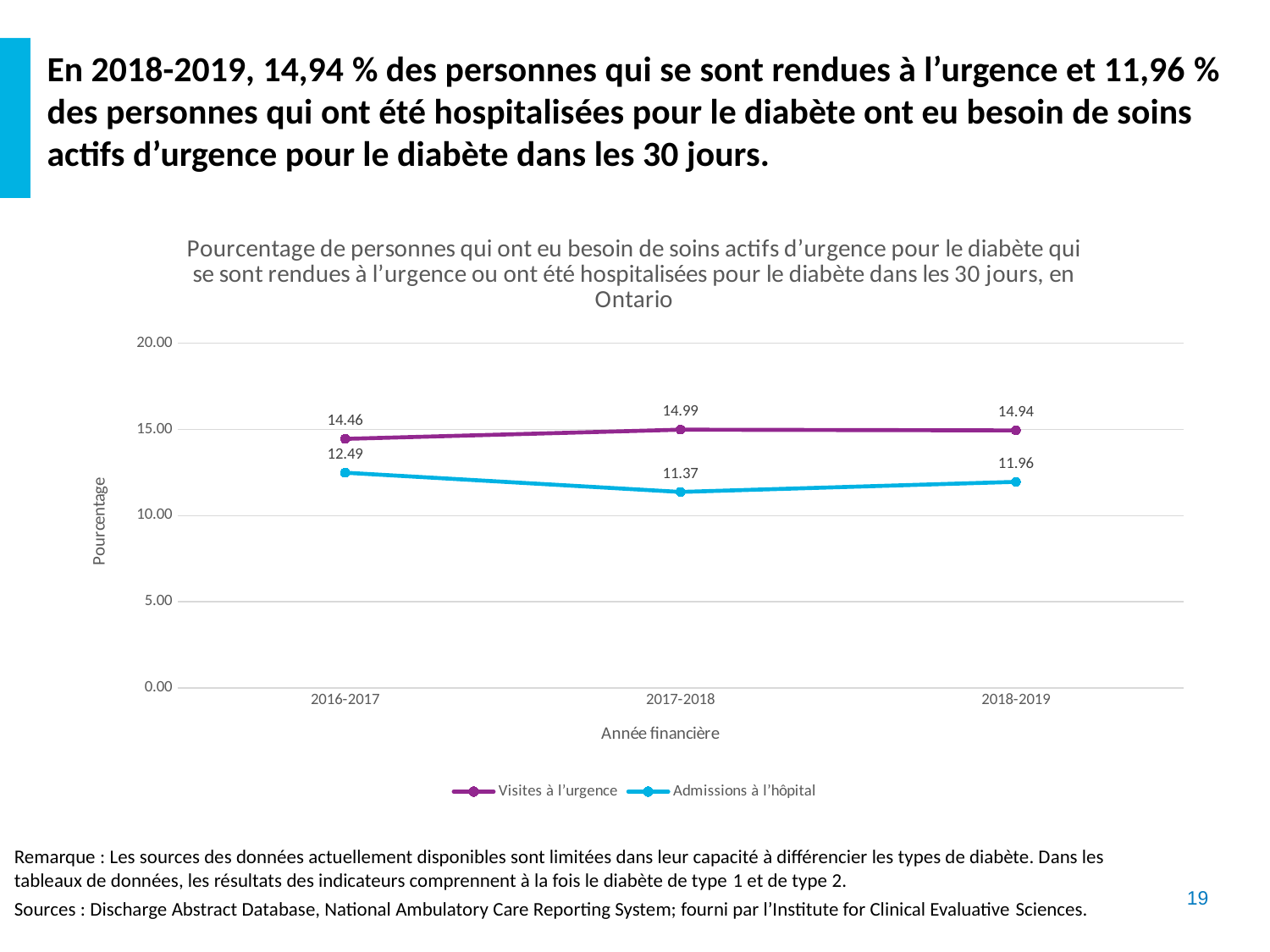
What is the value for Visites à l'urgence in 2016-2017? 14.46 What is the value for Admissions à l'hôpital in 2018-2019? 11.96 What is the value for Admissions à l'hôpital in 2017-2018? 11.37 What kind of chart is shown on the slide? line chart What is the label of the y axis? Pourcentage Which series has the larger value in 2016-2017, Visites à l'urgence or Admissions à l'hôpital? Visites à l'urgence In which fiscal year is the value for Admissions à l'hôpital lowest? 2017-2018 How many fiscal years are shown on the x axis? 3 What is the difference between Visites à l'urgence and Admissions à l'hôpital in 2018-2019? 2.98 Is the value for Admissions à l'hôpital in 2016-2017 greater or less than 15.00? less In which fiscal year is the value for Visites à l'urgence highest? 2017-2018 How many series does the legend list? 2